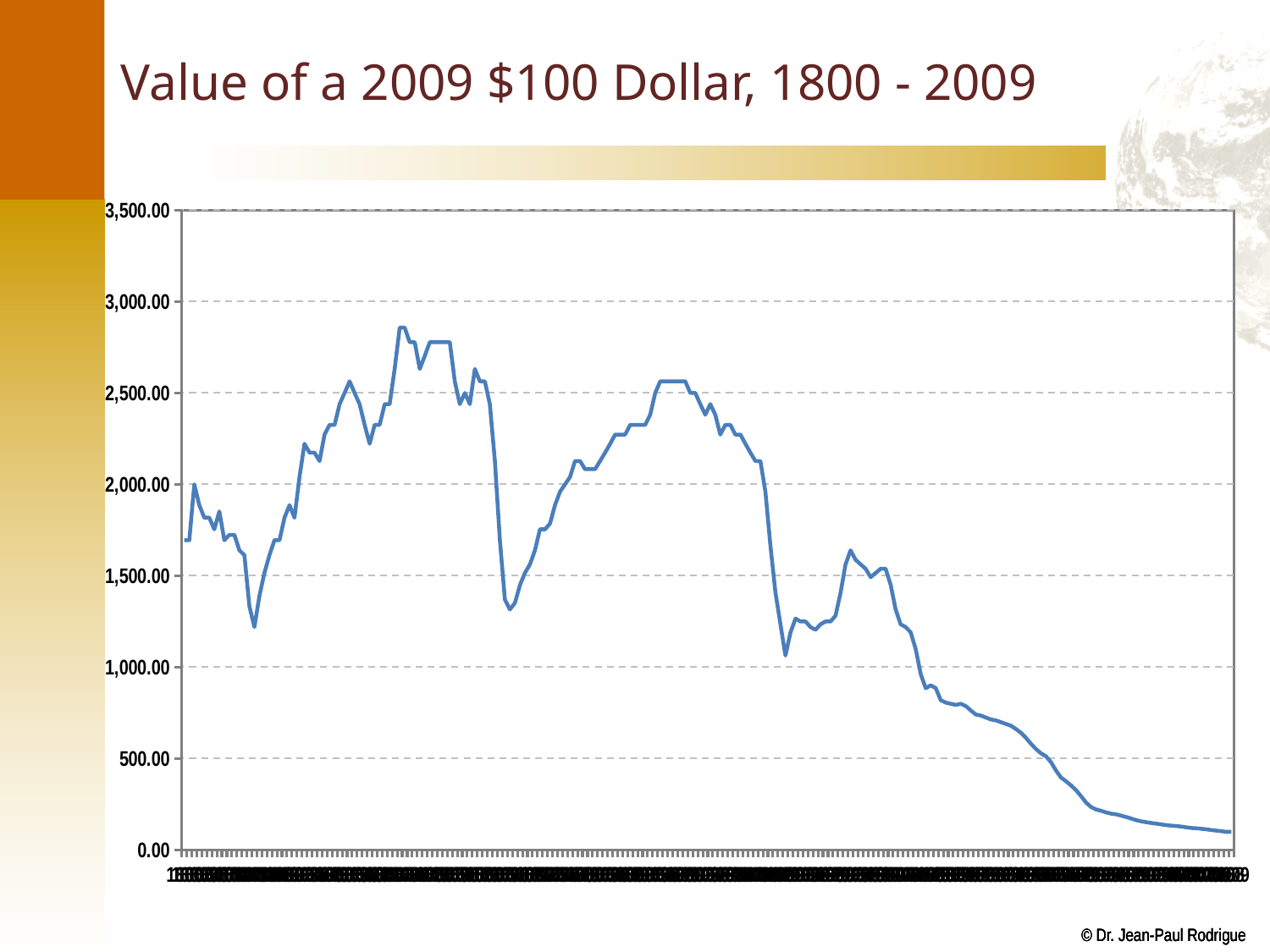
Is the value at the left end of the series (1800) greater or less than 1,500? greater Is the highest point of the line greater or less than 2,500? greater Overall, does the value rise or fall from the left end of the x axis to the right end? fall Is the highest point of the line greater or less than 3,000? less What is the highest tick value shown on the y axis? 3,500.00 What kind of chart is shown on the slide? line chart Is the value at the right end of the series higher or lower than the value at the left end? lower What is the title of the chart? Value of a 2009 $100 Dollar, 1800 - 2009 How many lines are plotted on the chart? 1